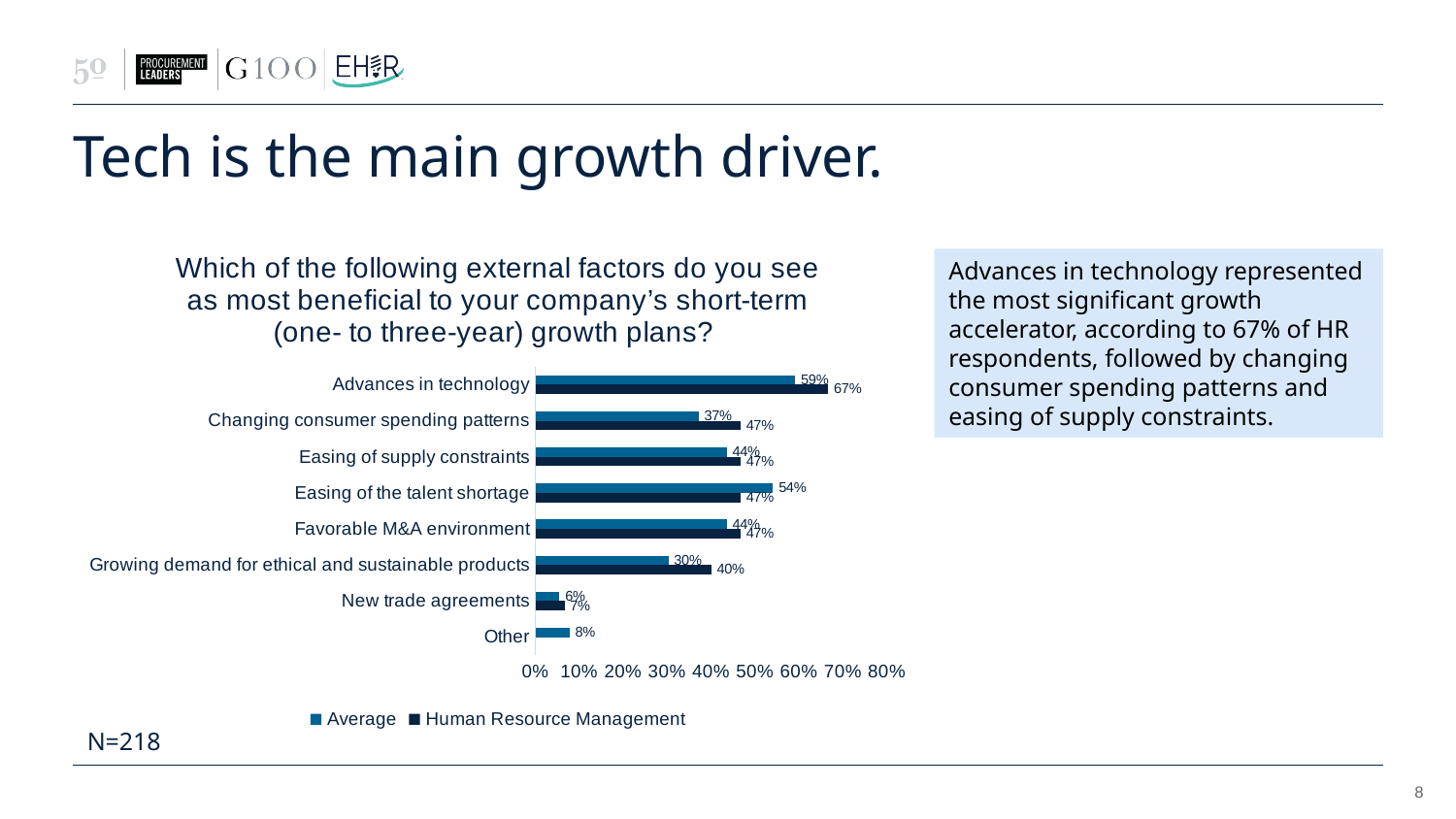
How many categories are shown on the chart? 8 What is the Human Resource Management value for Advances in technology? 67% Which series is shown in dark blue in the legend? Human Resource Management Which category has the highest Human Resource Management value? Advances in technology What is the Human Resource Management value for Growing demand for ethical and sustainable products? 40% What is the difference between the Human Resource Management and Average values for Advances in technology? 8% What type of chart is shown on the slide? bar chart For Easing of the talent shortage, which is larger: the Average value or the Human Resource Management value? Average Which category has the lowest Average value? New trade agreements How many series does the legend list? 2 What is the Average value for Advances in technology? 59% What is the Average value for Changing consumer spending patterns? 37%